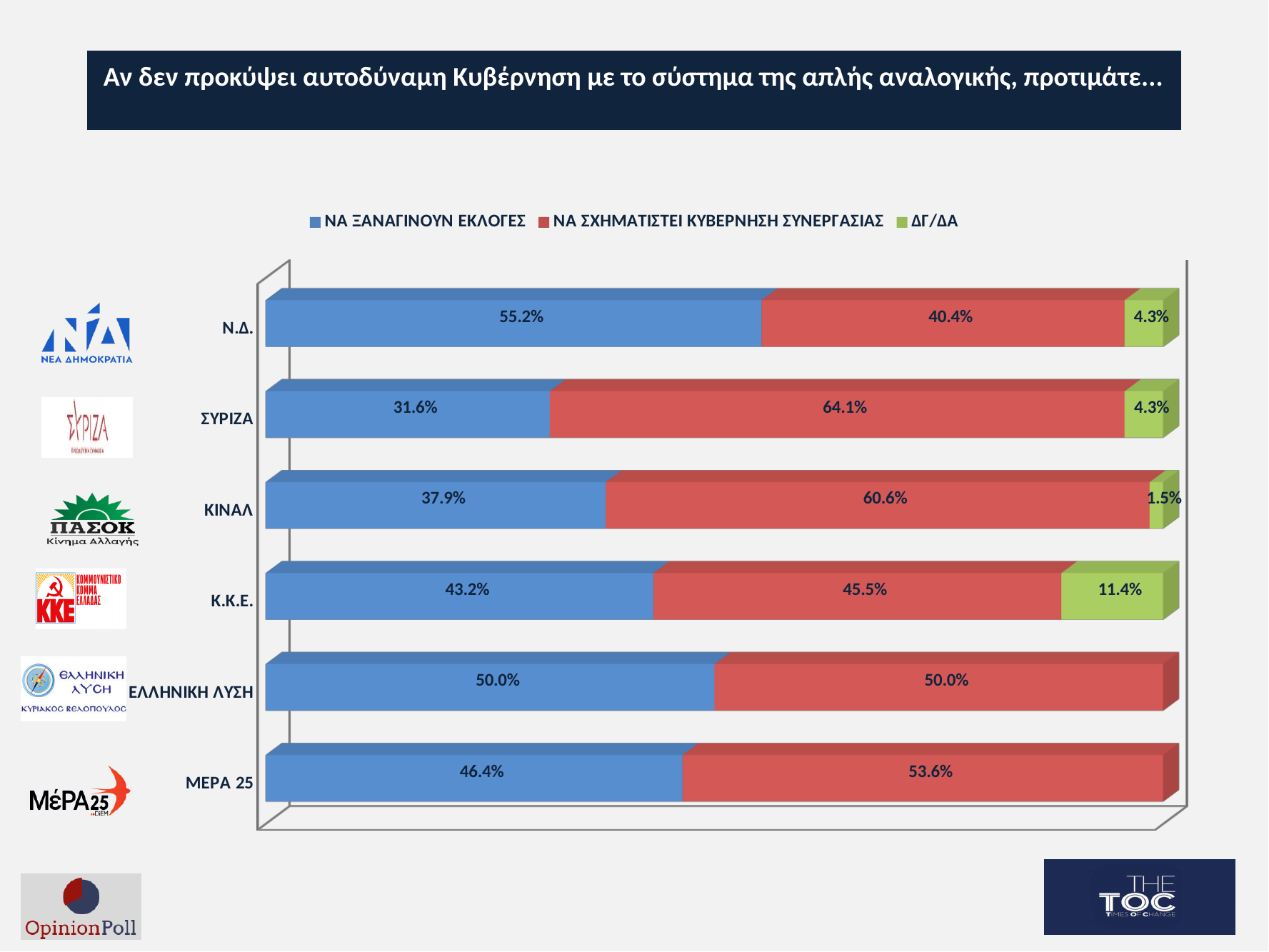
Which party has the lowest value for ΝΑ ΞΑΝΑΓΙΝΟΥΝ ΕΚΛΟΓΕΣ? ΣΥΡΙΖΑ Which party has the highest value for ΝΑ ΞΑΝΑΓΙΝΟΥΝ ΕΚΛΟΓΕΣ? Ν.Δ. How many series does the legend list? 3 What is the value for ΝΑ ΣΧΗΜΑΤΙΣΤΕΙ ΚΥΒΕΡΝΗΣΗ ΣΥΝΕΡΓΑΣΙΑΣ for ΣΥΡΙΖΑ? 64.1% What colour represents the ΔΓ/ΔΑ series in the chart? Green What is the value for ΝΑ ΞΑΝΑΓΙΝΟΥΝ ΕΚΛΟΓΕΣ for Ν.Δ.? 55.2% Which party has the lowest ΔΓ/ΔΑ value among those with a ΔΓ/ΔΑ label? ΚΙΝΑΛ For ΜΕΡΑ 25, which is larger: ΝΑ ΞΑΝΑΓΙΝΟΥΝ ΕΚΛΟΓΕΣ or ΝΑ ΣΧΗΜΑΤΙΣΤΕΙ ΚΥΒΕΡΝΗΣΗ ΣΥΝΕΡΓΑΣΙΑΣ? ΝΑ ΣΧΗΜΑΤΙΣΤΕΙ ΚΥΒΕΡΝΗΣΗ ΣΥΝΕΡΓΑΣΙΑΣ How many parties (categories) are shown in the chart? 6 What kind of chart is shown on the slide? Stacked bar chart What is the ΔΓ/ΔΑ value for Κ.Κ.Ε.? 11.4% What is the difference between the ΝΑ ΣΧΗΜΑΤΙΣΤΕΙ ΚΥΒΕΡΝΗΣΗ ΣΥΝΕΡΓΑΣΙΑΣ value and the ΝΑ ΞΑΝΑΓΙΝΟΥΝ ΕΚΛΟΓΕΣ value for ΚΙΝΑΛ? 22.7%